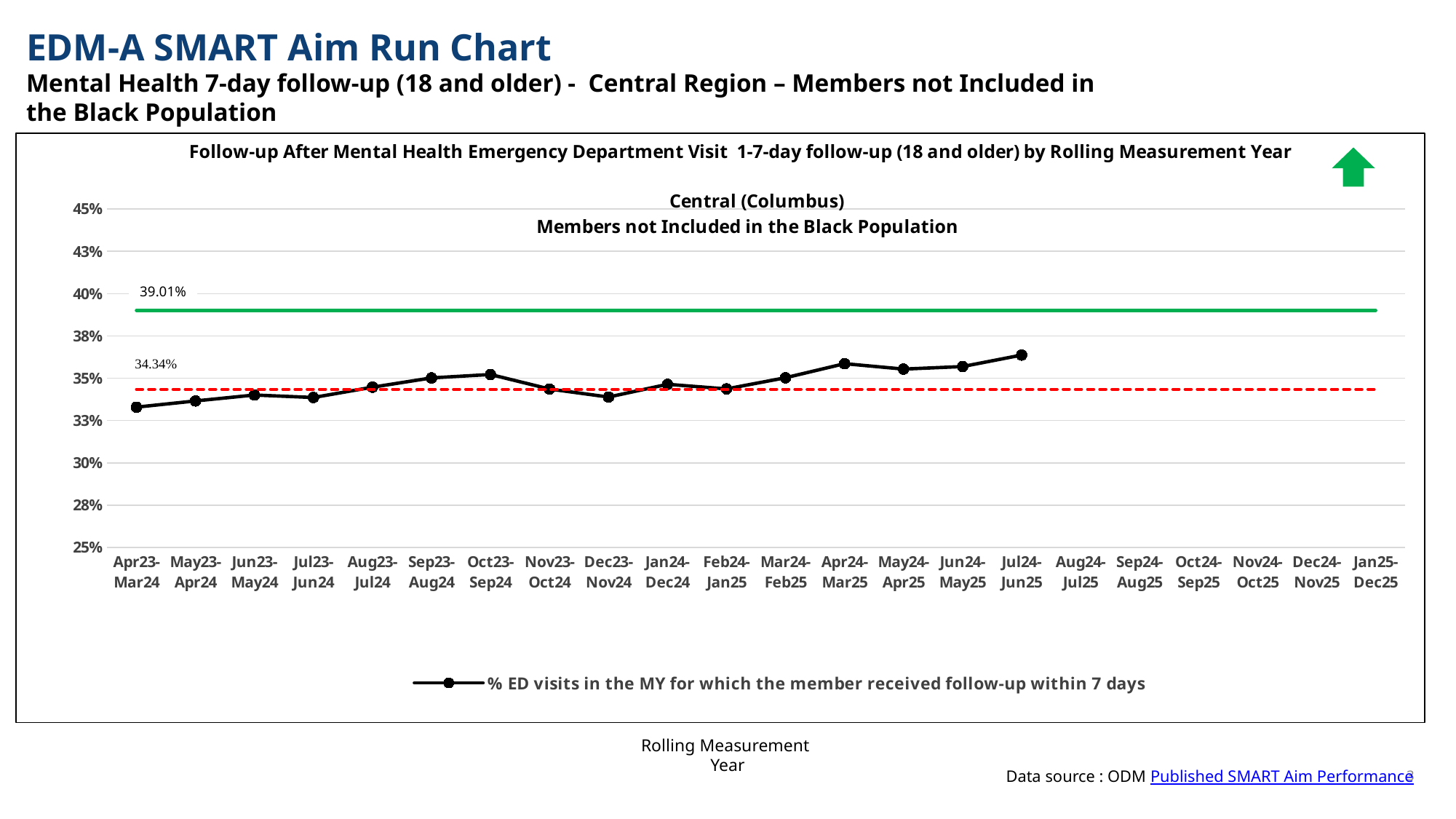
Is the value for Apr23-Mar24 greater or less than 35%? less What value is labelled on the solid green goal line? 39.01% What is the difference between the green goal line value and the red dashed baseline value? 4.67% Which rolling measurement year has the highest plotted value? Jul24-Jun25 How many series does the legend list? 1 How many data points are plotted on the line? 16 Which rolling measurement year has the lowest plotted value? Apr23-Mar24 What kind of chart is shown on the slide? line chart Is the value for Jul24-Jun25 greater or less than 35%? greater What value is labelled on the red dashed baseline? 34.34% How many rolling measurement year categories are shown on the x axis? 22 Which is larger, the value for Oct23-Sep24 or the value for Dec23-Nov24? Oct23-Sep24